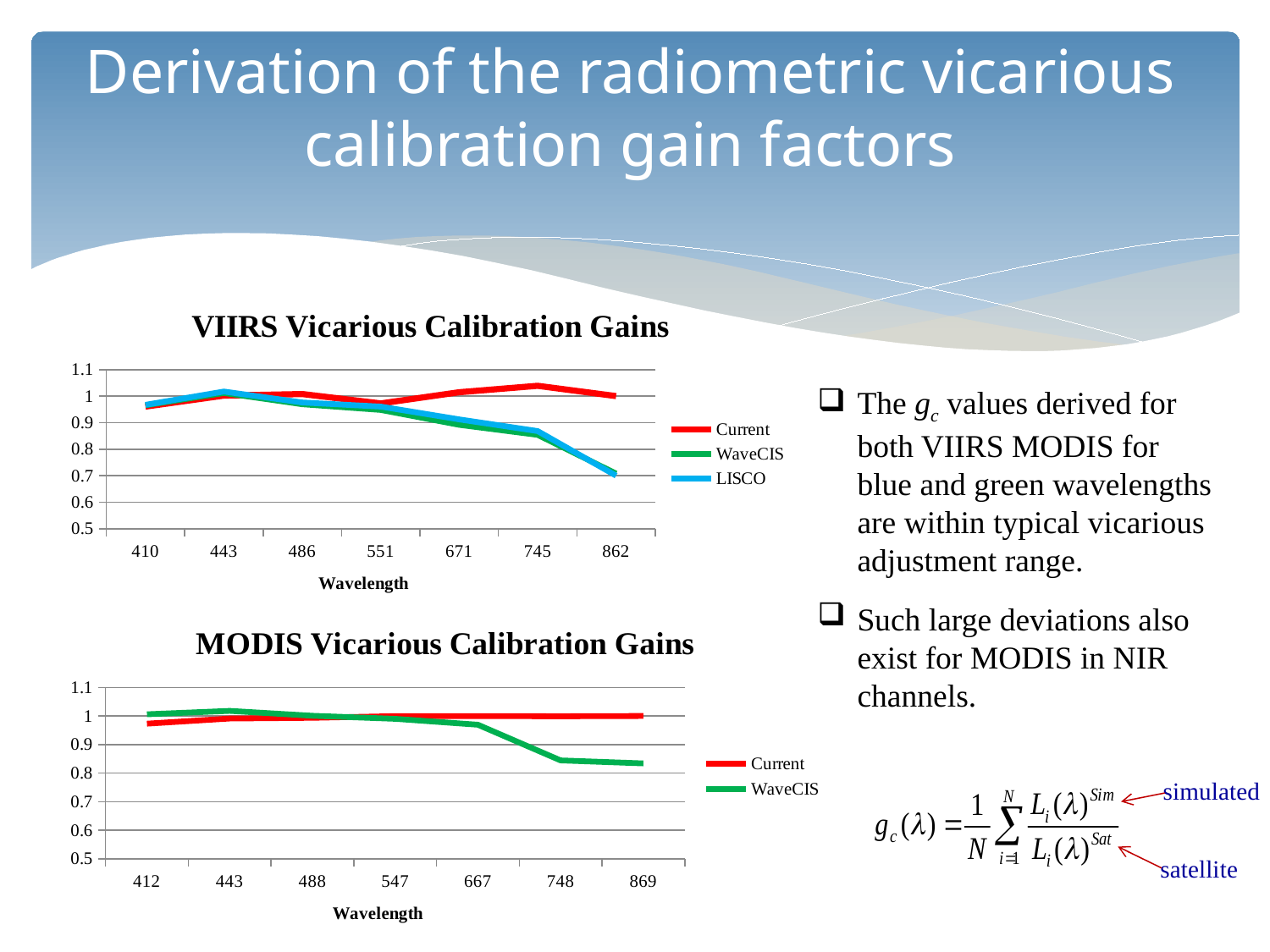
In the MODIS Vicarious Calibration Gains chart, is the WaveCIS value at 869 greater or less than 0.9? less In the VIIRS Vicarious Calibration Gains chart, at which wavelength does the Current series reach its highest value? 745 How many wavelength categories are shown on the x axis of the MODIS Vicarious Calibration Gains chart? 7 In the VIIRS Vicarious Calibration Gains chart, which series has the higher value at 862, Current or LISCO? Current How many wavelength categories are shown on the x axis of the VIIRS Vicarious Calibration Gains chart? 7 How many series does the legend of the VIIRS Vicarious Calibration Gains chart list? 3 How many series does the legend of the MODIS Vicarious Calibration Gains chart list? 2 In the VIIRS Vicarious Calibration Gains chart, is the WaveCIS value at 862 greater or less than 0.8? less What type of chart is the VIIRS Vicarious Calibration Gains chart? line chart In the MODIS Vicarious Calibration Gains chart, which series has the higher value at 748, Current or WaveCIS? Current In the VIIRS Vicarious Calibration Gains chart, is the Current value at 745 greater or less than 1? greater In the VIIRS Vicarious Calibration Gains chart, does the LISCO series generally rise or fall from 443 to 862? fall